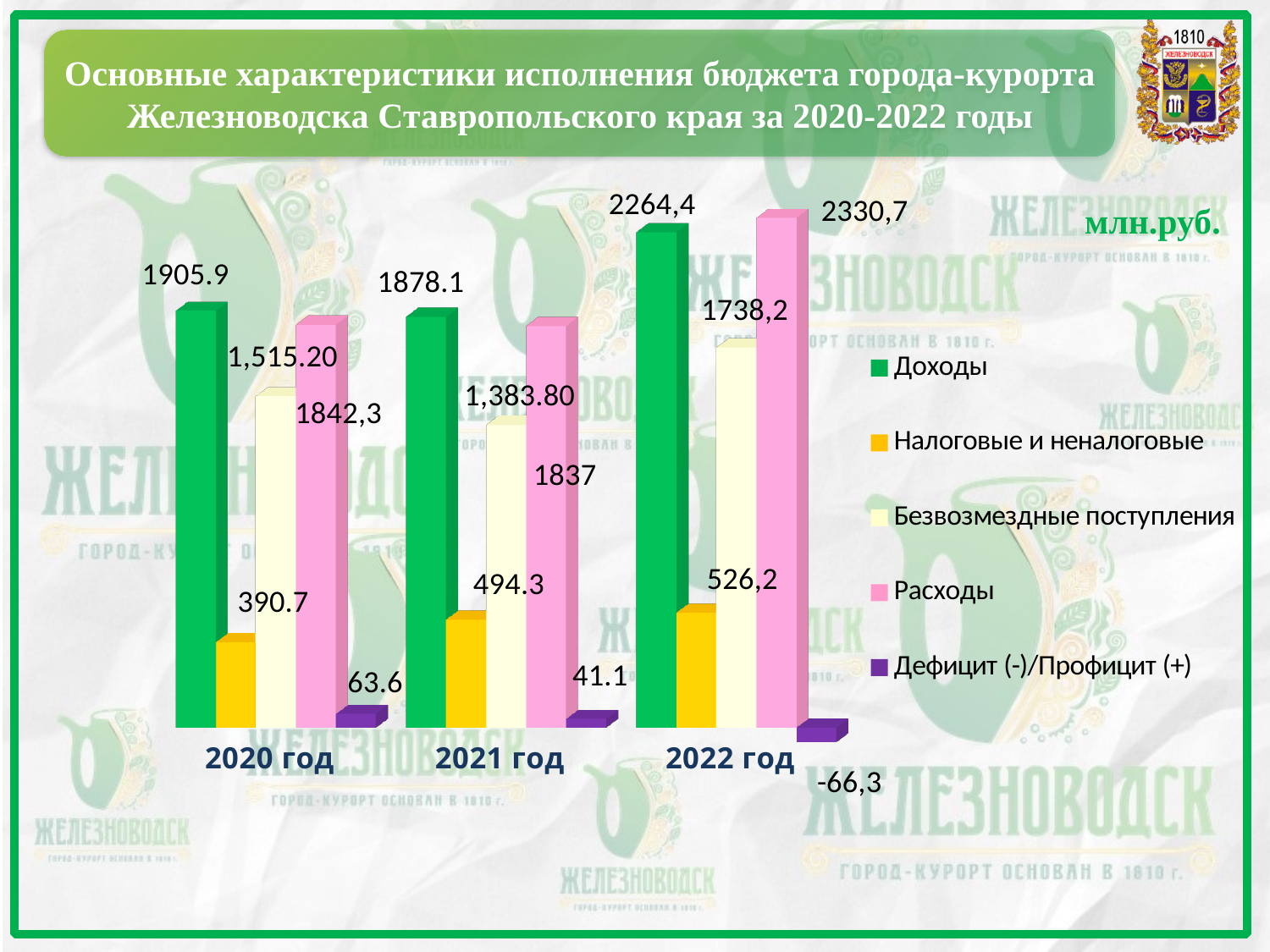
What is the value of Расходы for 2022 год? 2330,7 In which year is Доходы the highest? 2022 год Do the values of Налоговые и неналоговые rise or fall from 2020 год to 2022 год? Rise What is the value of Налоговые и неналоговые for 2020 год? 390.7 What is the value of Безвозмездные поступления for 2021 год? 1,383.80 What kind of chart is shown on the slide? Bar chart In which year is Налоговые и неналоговые the lowest? 2020 год What is the difference between Расходы and Доходы for 2022 год? 66,3 How many series does the legend list? 5 What is the value of Дефицит (-)/Профицит (+) for 2022 год? -66,3 Which is larger for 2021 год: Доходы or Расходы? Доходы What is the value of Доходы for 2020 год? 1905.9